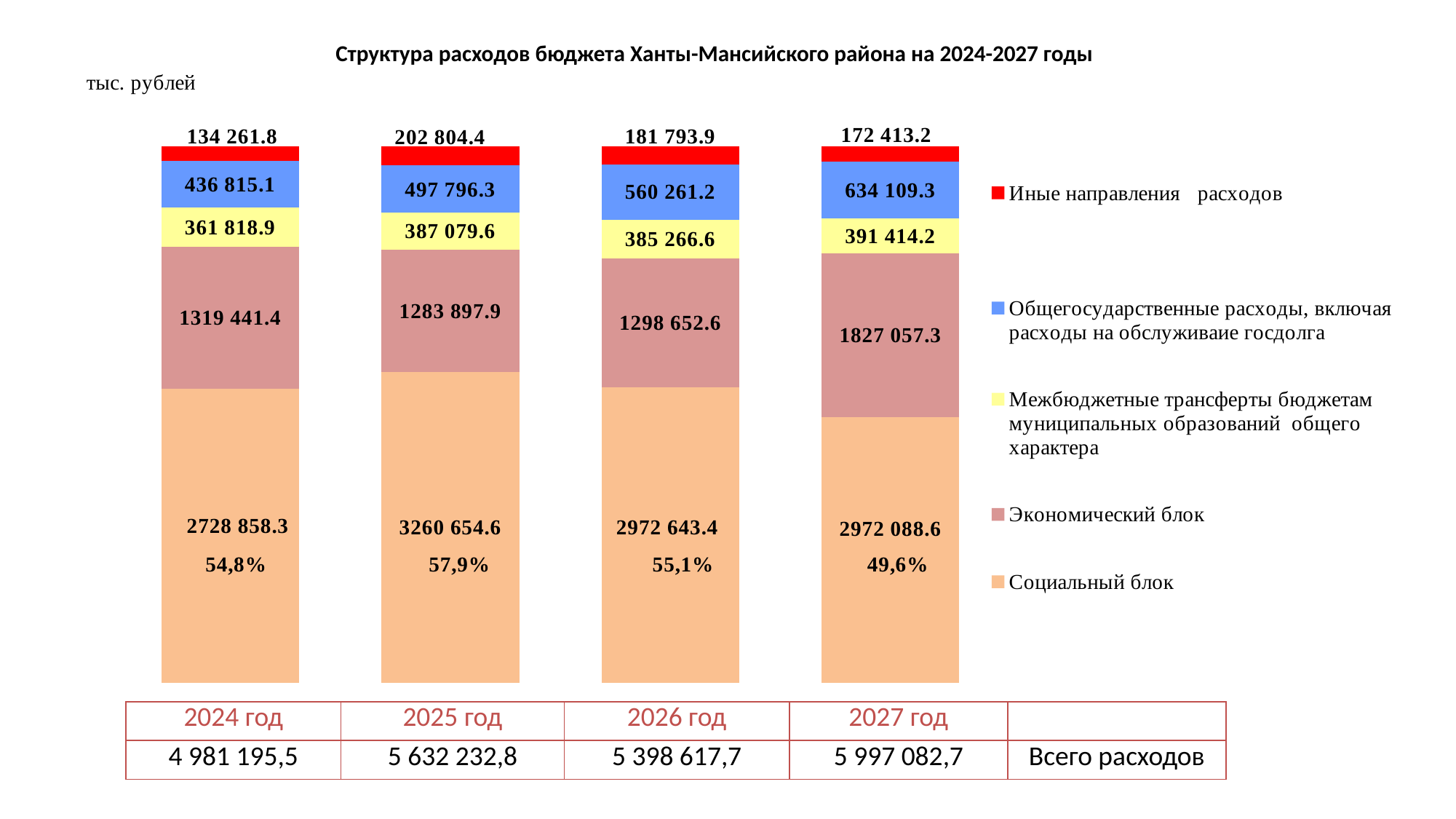
What is the difference between the Общегосударственные расходы values for 2027 год and 2024 год? 197 294.2 In which year is the Социальный блок value the highest? 2025 год What is the value of Экономический блок for 2027 год? 1827 057.3 What is the value of Иные направления расходов for 2025 год? 202 804.4 Which is larger: Межбюджетные трансферты in 2025 год or in 2026 год? 2025 год What share of total expenditure does Социальный блок make up in 2026 год, as printed on the bar? 55,1% In which year is the Иные направления расходов value the lowest? 2024 год What is the value of Социальный блок for 2024 год? 2728 858.3 What type of chart is shown on the slide? Stacked bar chart How many years (bars) are shown in the chart? 4 Does the Общегосударственные расходы value rise or fall from 2024 год to 2027 год? Rise How many series does the legend list? 5